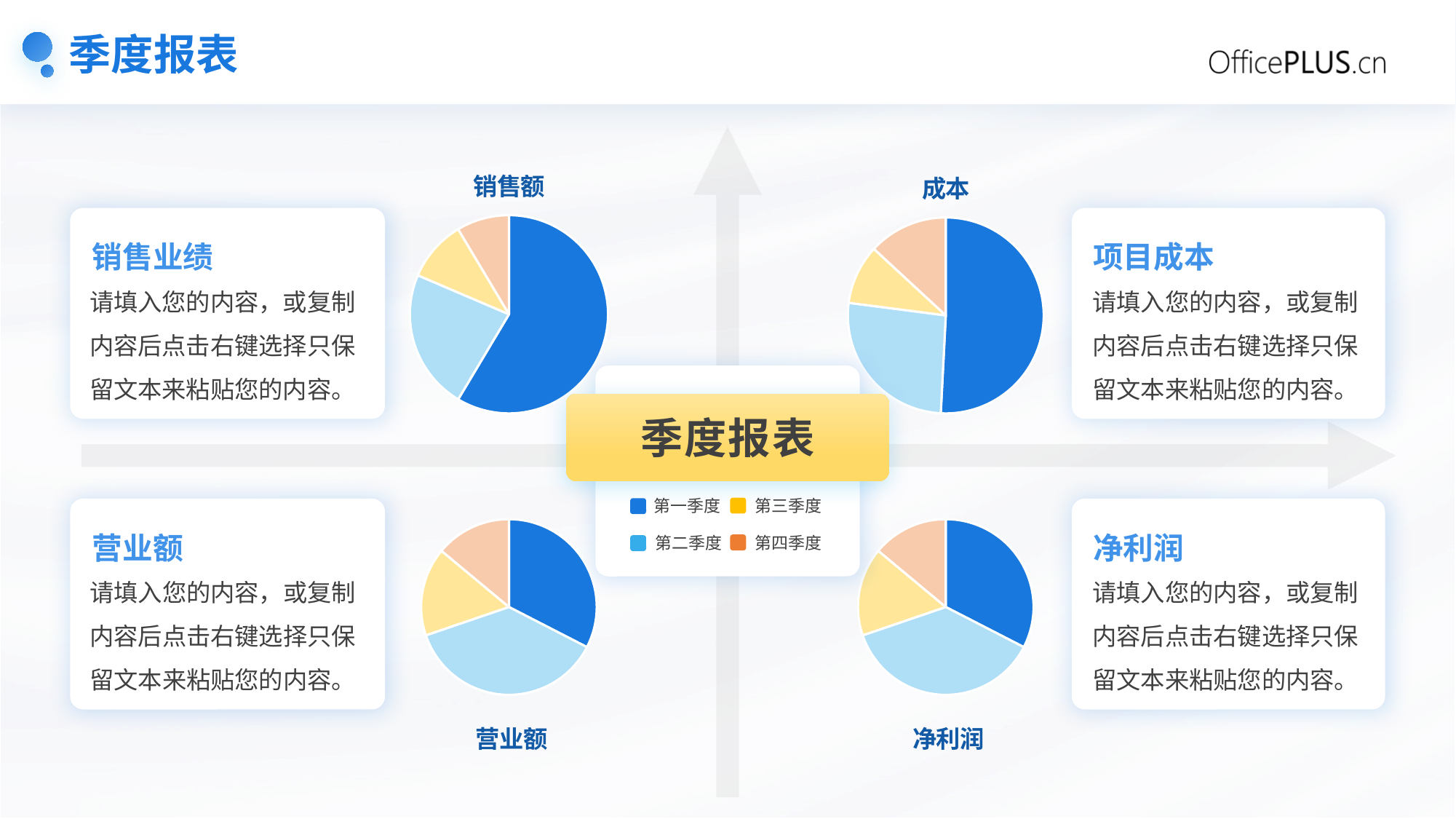
In the 销售额 pie chart, which slice is larger, 第一季度 or 第二季度? 第一季度 In the 成本 pie chart, which quarter has the largest slice? 第一季度 How many slices does the 成本 pie chart have? 4 What kind of chart is the 销售额 chart? pie chart In the 净利润 pie chart, which slice is larger, 第一季度 or 第三季度? 第一季度 In the 成本 pie chart, which slice is larger, 第二季度 or 第四季度? 第二季度 In the 营业额 pie chart, which quarter has the largest slice? 第二季度 In the 销售额 pie chart, which quarter has the largest slice? 第一季度 Which legend entry is shown in dark blue? 第一季度 How many pie charts are shown on the slide? 4 How many series does the legend in the centre of the slide list? 4